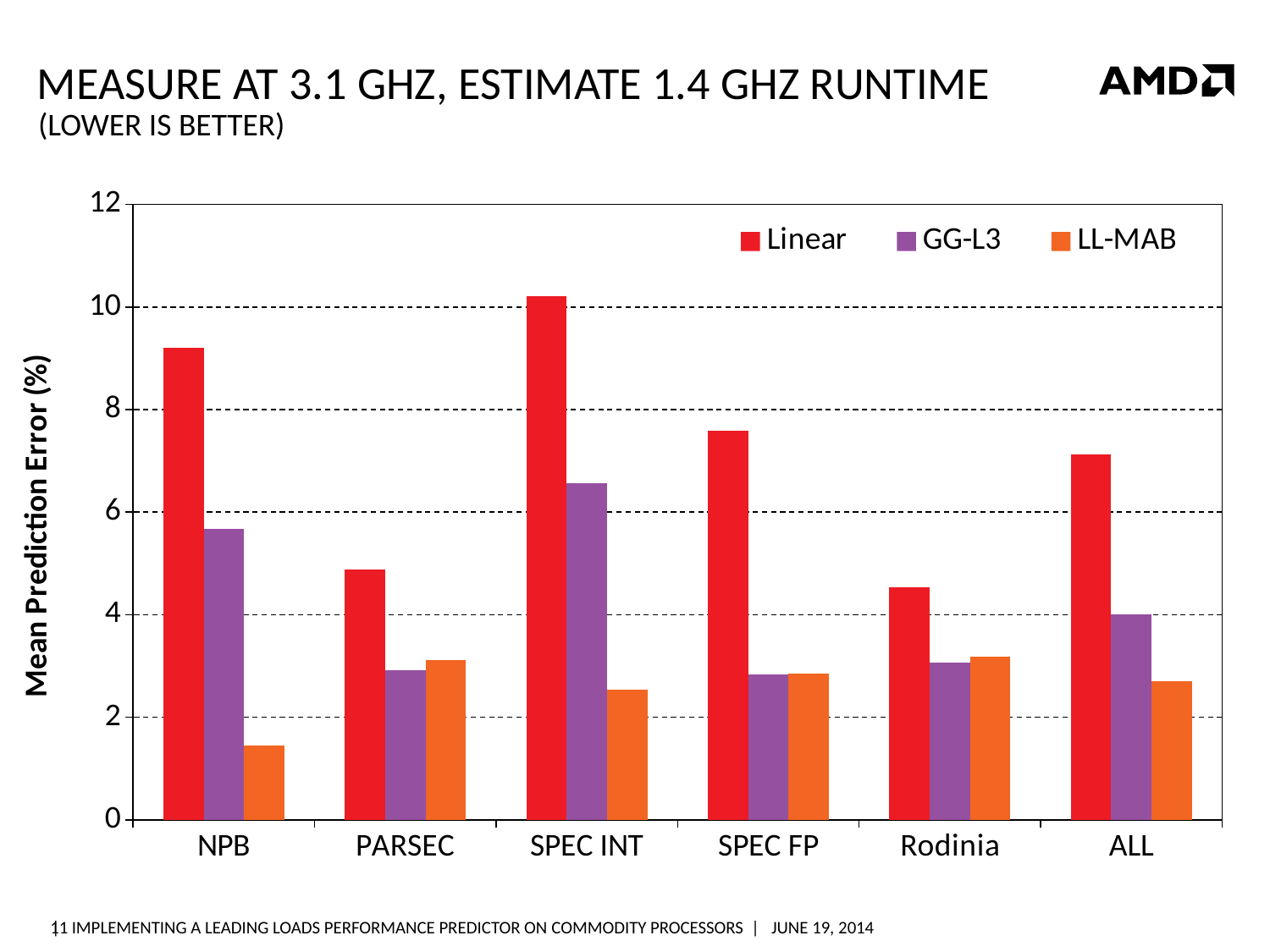
What is the label of the y axis? Mean Prediction Error (%) Is the Linear value for SPEC INT greater or less than 10? greater For which category is the Linear series highest? SPEC INT Is the Linear value for ALL greater or less than 6? greater For which category is the LL-MAB series lowest? NPB How many benchmark categories are shown on the x axis? 6 For SPEC INT, which is larger: the GG-L3 value or the LL-MAB value? GG-L3 What kind of chart is shown on the slide? bar chart For NPB, which is larger: the Linear value or the GG-L3 value? Linear For which category is the GG-L3 series highest? SPEC INT How many series does the legend list? 3 Is the LL-MAB value for NPB greater or less than 2? less